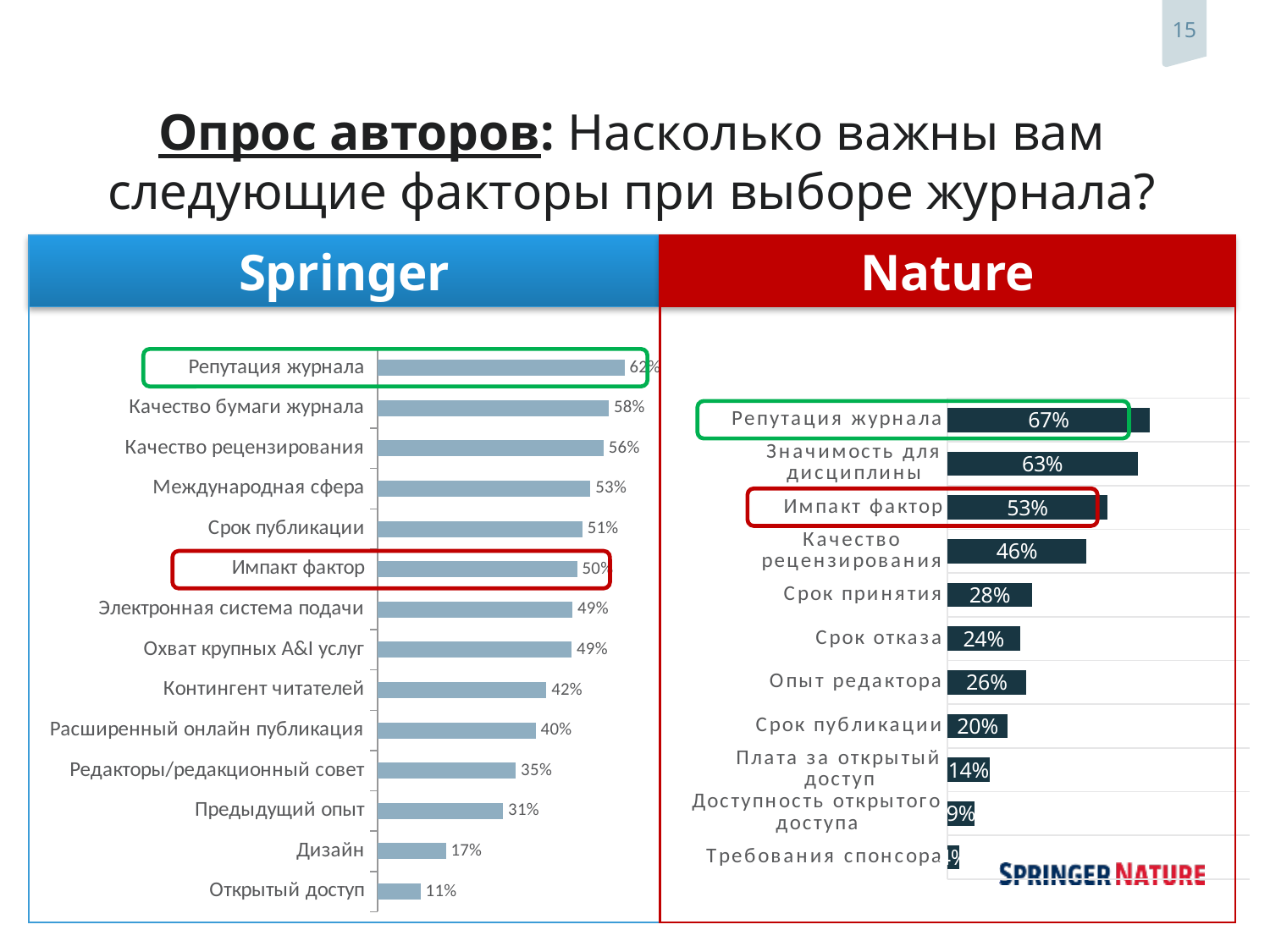
In the Springer chart, which factor has the lowest value? Открытый доступ In the Springer chart, what value is shown for Дизайн? 17% In the Nature chart, what value is shown for Срок отказа? 24% What type of chart is the Nature chart? Bar chart In the Nature chart, which factor has the highest value? Репутация журнала In the Nature chart, which is larger: Опыт редактора or Срок отказа? Опыт редактора In the Nature chart, what is the difference between Значимость для дисциплины and Срок публикации? 43% In the Springer chart, do the values rise or fall from top to bottom? Fall In the Nature chart, what percentage is shown for Импакт фактор? 53% In the Springer chart, what is the difference between Качество бумаги журнала and Предыдущий опыт? 27% In the Springer chart, what percentage is shown for Репутация журнала? 62% How many factors are listed in the Springer chart? 14